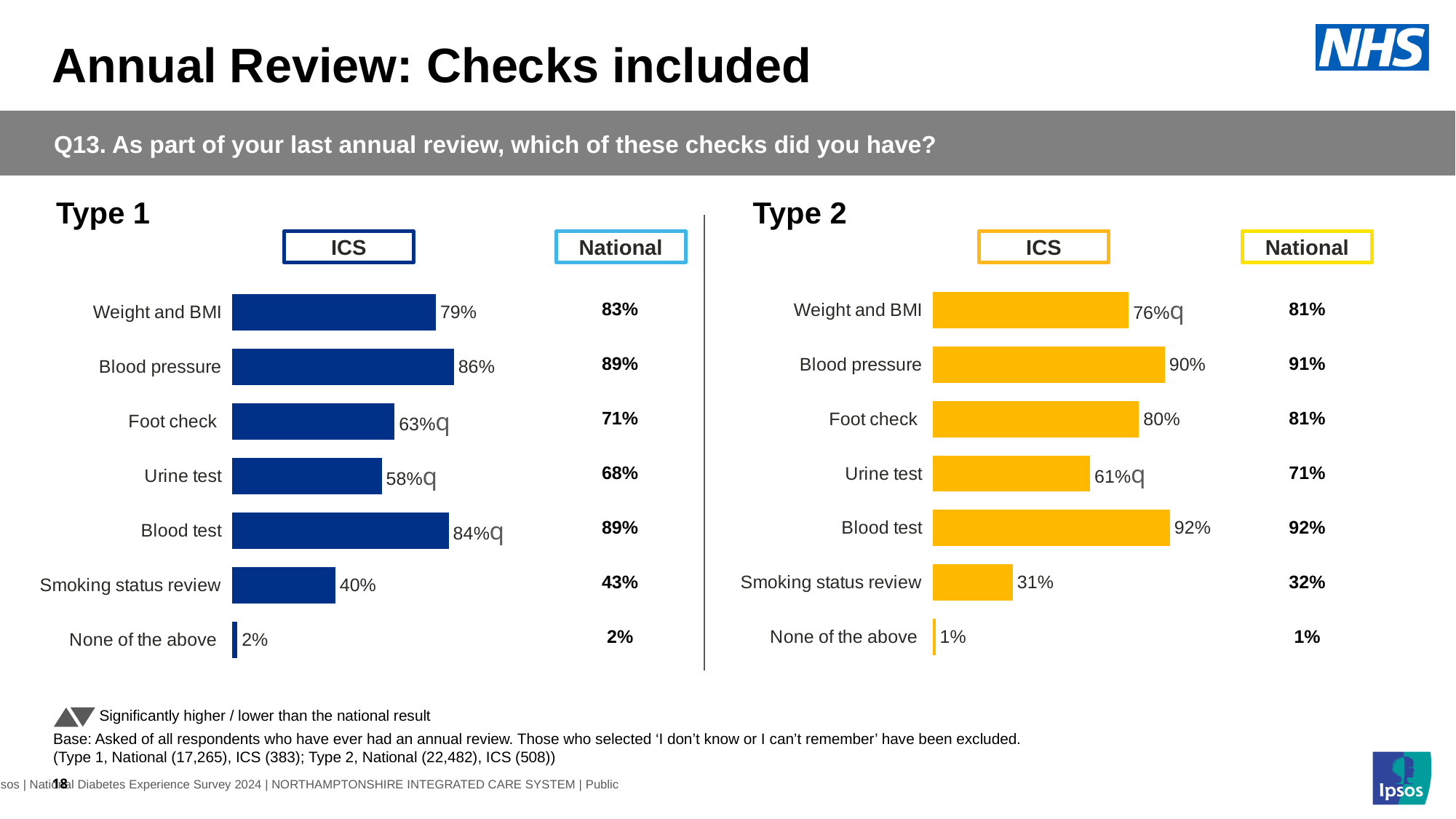
How many categories are shown in the Type 1 chart? 7 In the Type 2 chart, what is the difference between the ICS values for Blood pressure and Smoking status review? 59 percentage points What type of chart is used for the Type 2 ICS results? bar chart What colour are the bars in the Type 2 chart? yellow In the Type 2 chart, is the ICS value for Foot check higher or lower than the National value? lower In the Type 1 chart, what is the National value for Foot check? 71% In the Type 2 chart, what is the ICS value for Urine test? 61% In the Type 1 chart, what is the ICS value for Blood pressure? 86% In the Type 2 chart, which check has the highest ICS value? Blood test In the Type 1 chart, which is larger: the ICS value for Weight and BMI or the ICS value for Blood test? Blood test In the Type 1 chart, which category has the lowest ICS value? None of the above In the Type 1 chart, what is the difference between the National and ICS values for Urine test? 10 percentage points